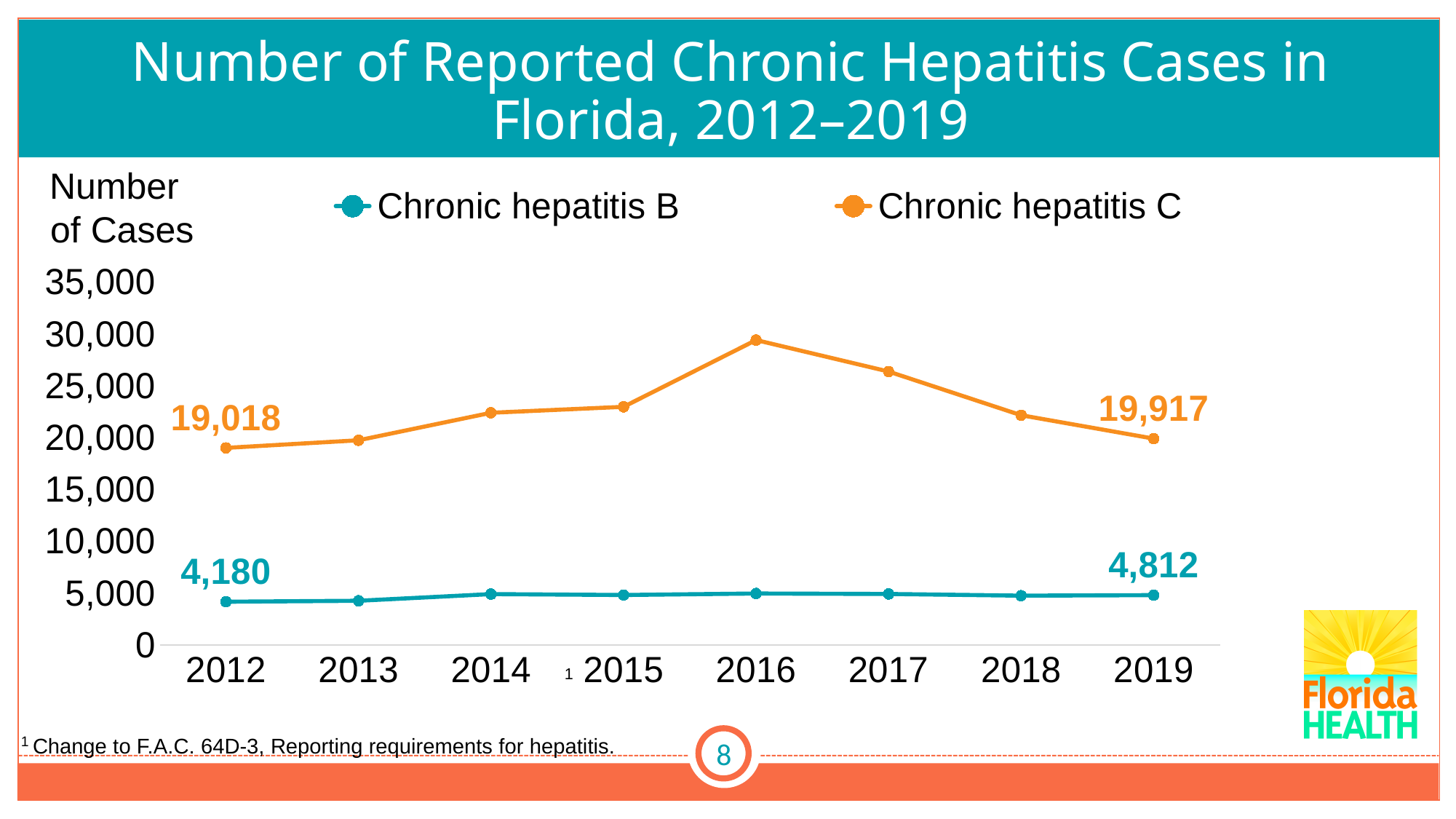
What is the number of reported chronic hepatitis B cases in Florida in 2019? 4,812 What is the number of reported chronic hepatitis C cases in Florida in 2019? 19,917 How many series does the legend list? 2 In which year did chronic hepatitis C cases peak? 2016 By how much did the number of chronic hepatitis B cases change from 2012 to 2019? 632 Is the number of chronic hepatitis C cases in 2016 greater or less than 25,000? greater By how much did the number of chronic hepatitis C cases change from 2012 to 2019? 899 What is the number of reported chronic hepatitis B cases in Florida in 2012? 4,180 Is the number of chronic hepatitis B cases in 2016 greater or less than 10,000? less Which series had more cases in 2017, chronic hepatitis B or chronic hepatitis C? Chronic hepatitis C What is the number of reported chronic hepatitis C cases in Florida in 2012? 19,018 What kind of chart is shown on the slide? Line chart